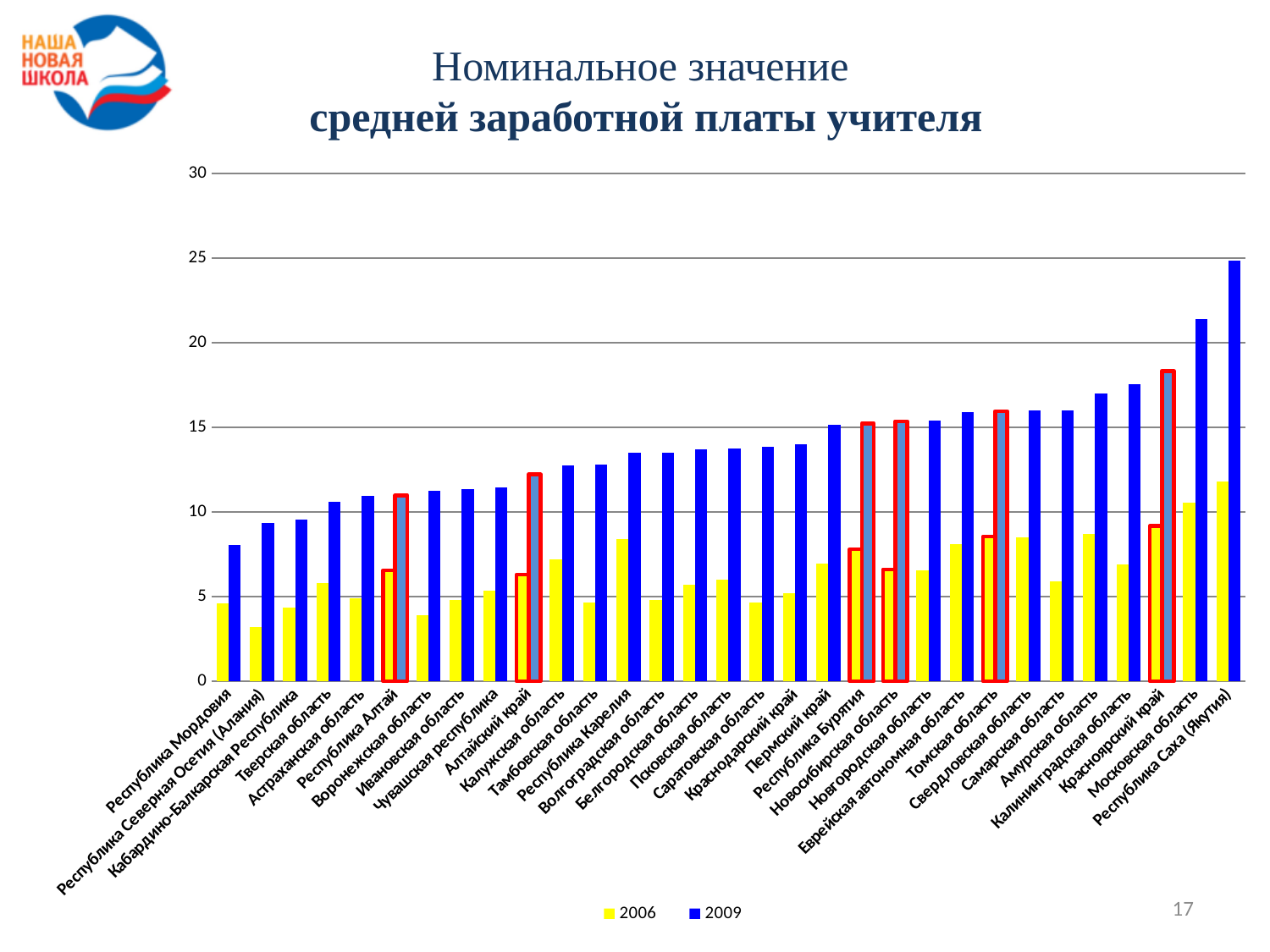
Is the 2009 value for Республика Мордовия greater or less than 10? less Do the 2009 values generally rise or fall moving from left to right along the x axis? rise Which region has the lowest value for 2006? Республика Северная Осетия (Алания) Which is larger, the 2009 value for Московская область or the 2009 value for Красноярский край? Московская область Is the 2009 value for Московская область greater or less than 20? greater How many series does the legend list? 2 Which region has the lowest value for 2009? Республика Мордовия What kind of chart is shown on the slide? bar chart Is the 2006 value for Воронежская область greater or less than 5? less Which colour represents the 2006 series in the legend? yellow How many regions (categories) are shown on the x axis? 31 Which region has the highest value for 2009? Республика Саха (Якутия)